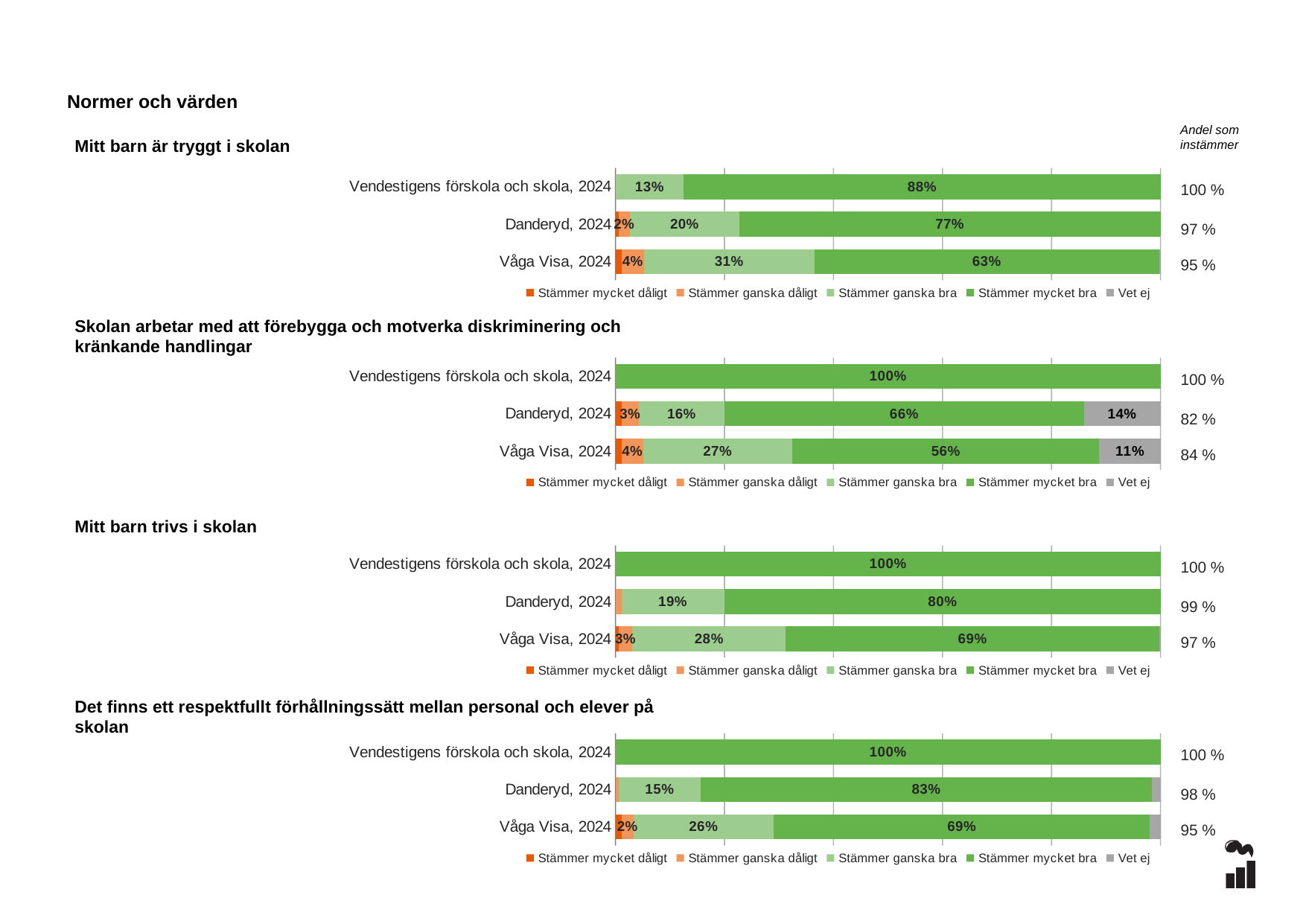
In the chart 'Skolan arbetar med att förebygga och motverka diskriminering och kränkande handlingar', what is the 'Vet ej' value for Danderyd, 2024? 14% In the chart 'Mitt barn är tryggt i skolan', what is the 'Stämmer mycket bra' value for Vendestigens förskola och skola, 2024? 88% In the chart 'Det finns ett respektfullt förhållningssätt mellan personal och elever på skolan', which is larger: the 'Stämmer mycket bra' value for Danderyd, 2024 or for Våga Visa, 2024? Danderyd, 2024 In the chart 'Mitt barn trivs i skolan', what is the 'Stämmer mycket bra' value for Danderyd, 2024? 80% In the chart 'Skolan arbetar med att förebygga och motverka diskriminering och kränkande handlingar', which category has the highest 'Stämmer mycket bra' value? Vendestigens förskola och skola, 2024 In the chart 'Mitt barn trivs i skolan', what is the difference between the 'Stämmer mycket bra' values for Danderyd, 2024 and Våga Visa, 2024? 11% How many series does the legend of the chart 'Mitt barn trivs i skolan' list? 5 How many categories are shown in the chart 'Skolan arbetar med att förebygga och motverka diskriminering och kränkande handlingar'? 3 What kind of chart is 'Mitt barn är tryggt i skolan'? Stacked bar chart In the chart 'Mitt barn är tryggt i skolan', what is the 'Stämmer ganska bra' value for Våga Visa, 2024? 31% In the chart 'Det finns ett respektfullt förhållningssätt mellan personal och elever på skolan', what is the 'Stämmer ganska bra' value for Danderyd, 2024? 15% In the chart 'Mitt barn är tryggt i skolan', which category has the lowest 'Stämmer mycket bra' value? Våga Visa, 2024